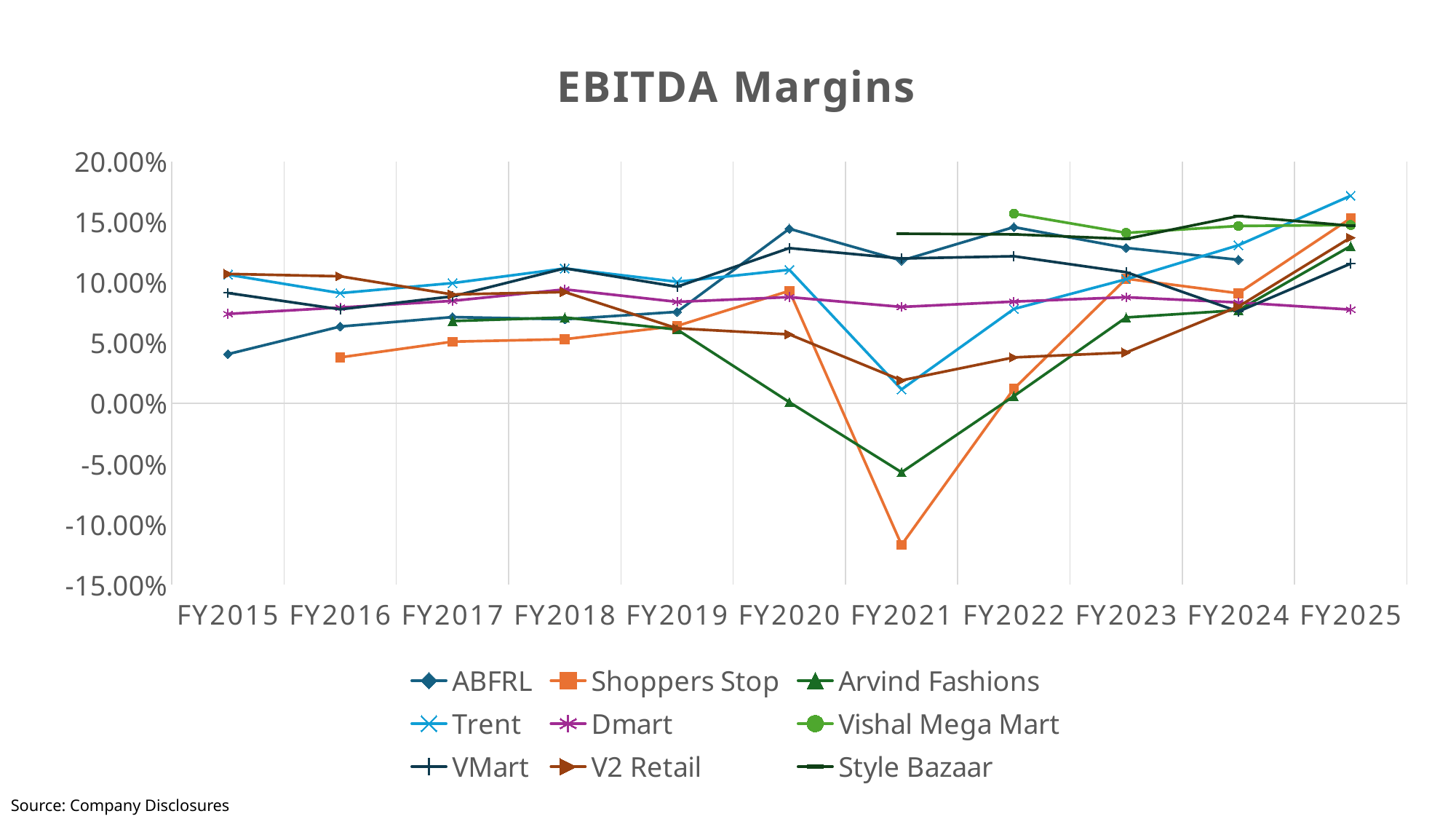
Is the value for Shoppers Stop in FY2021 greater or less than -10.00%? less How many fiscal years are shown on the x axis? 11 Is the value for Trent in FY2025 greater or less than 15.00%? greater Is the value for Arvind Fashions in FY2021 greater or less than 0.00%? less How many series does the legend list? 9 In FY2021, which is larger: the value for Arvind Fashions or the value for Shoppers Stop? Arvind Fashions Which series has the lowest value in FY2021? Shoppers Stop What kind of chart is shown on the slide? line chart Does the value for Shoppers Stop rise or fall from FY2021 to FY2025? rise Which series has the highest value in FY2025? Trent What is the title of the chart? EBITDA Margins